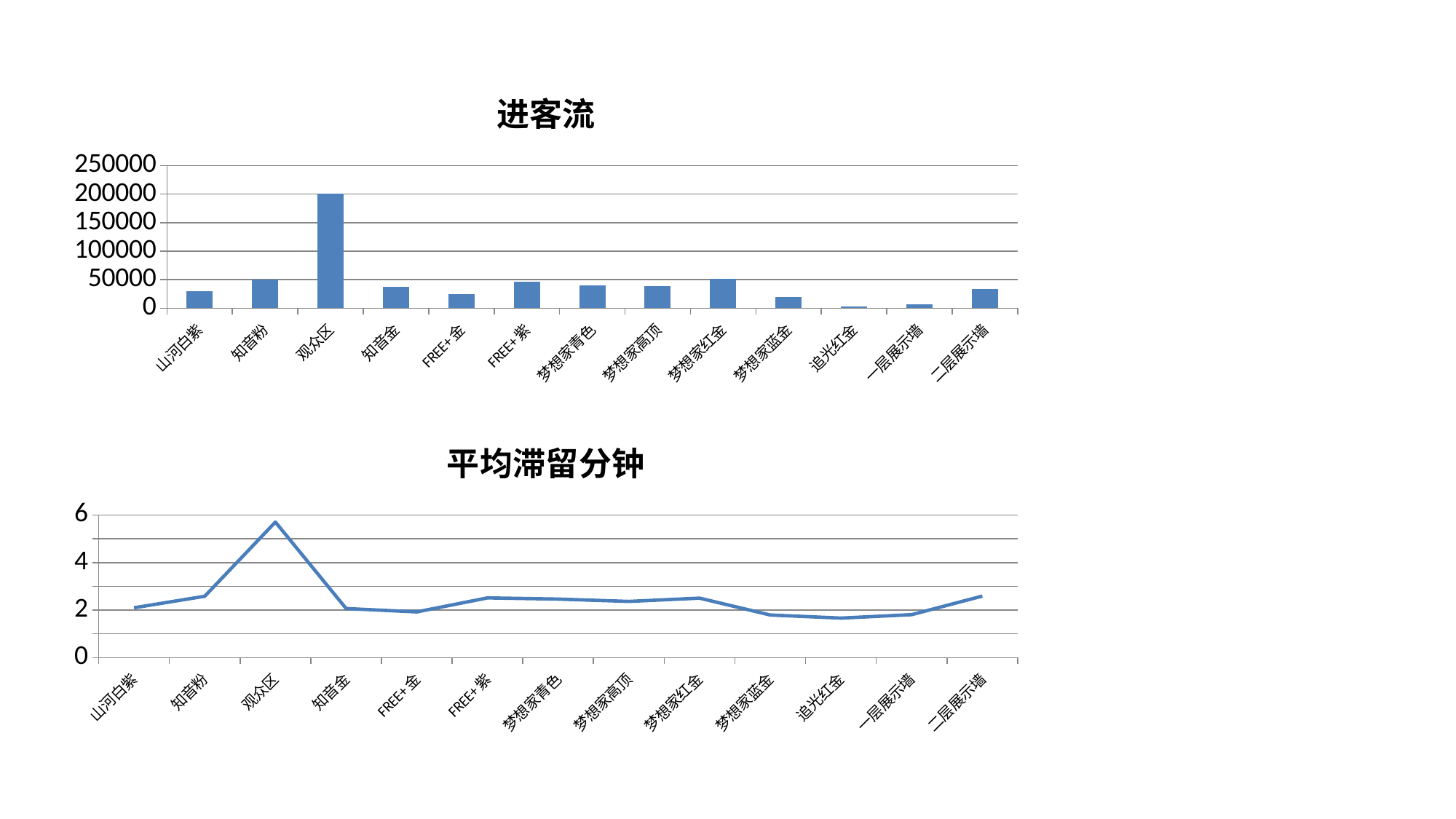
What kind of chart is the top chart titled 进客流? bar chart How many categories are shown on the x axis of the 进客流 chart? 13 In the 进客流 chart, is the value for 山河白紫 greater or less than 50000? less In the 平均滞留分钟 chart, which category has the highest value? 观众区 In the 进客流 chart, which category has the highest value? 观众区 In the 进客流 chart, is the value for 观众区 greater or less than 150000? greater What is the title of the top chart on the slide? 进客流 What kind of chart is the bottom chart titled 平均滞留分钟? line chart In the 进客流 chart, which is larger, the value for 知音粉 or the value for 山河白紫? 知音粉 In the 进客流 chart, which category has the lowest value? 追光红金 In the 平均滞留分钟 chart, is the value for 观众区 greater or less than 4? greater In the 平均滞留分钟 chart, which category has the lowest value? 追光红金